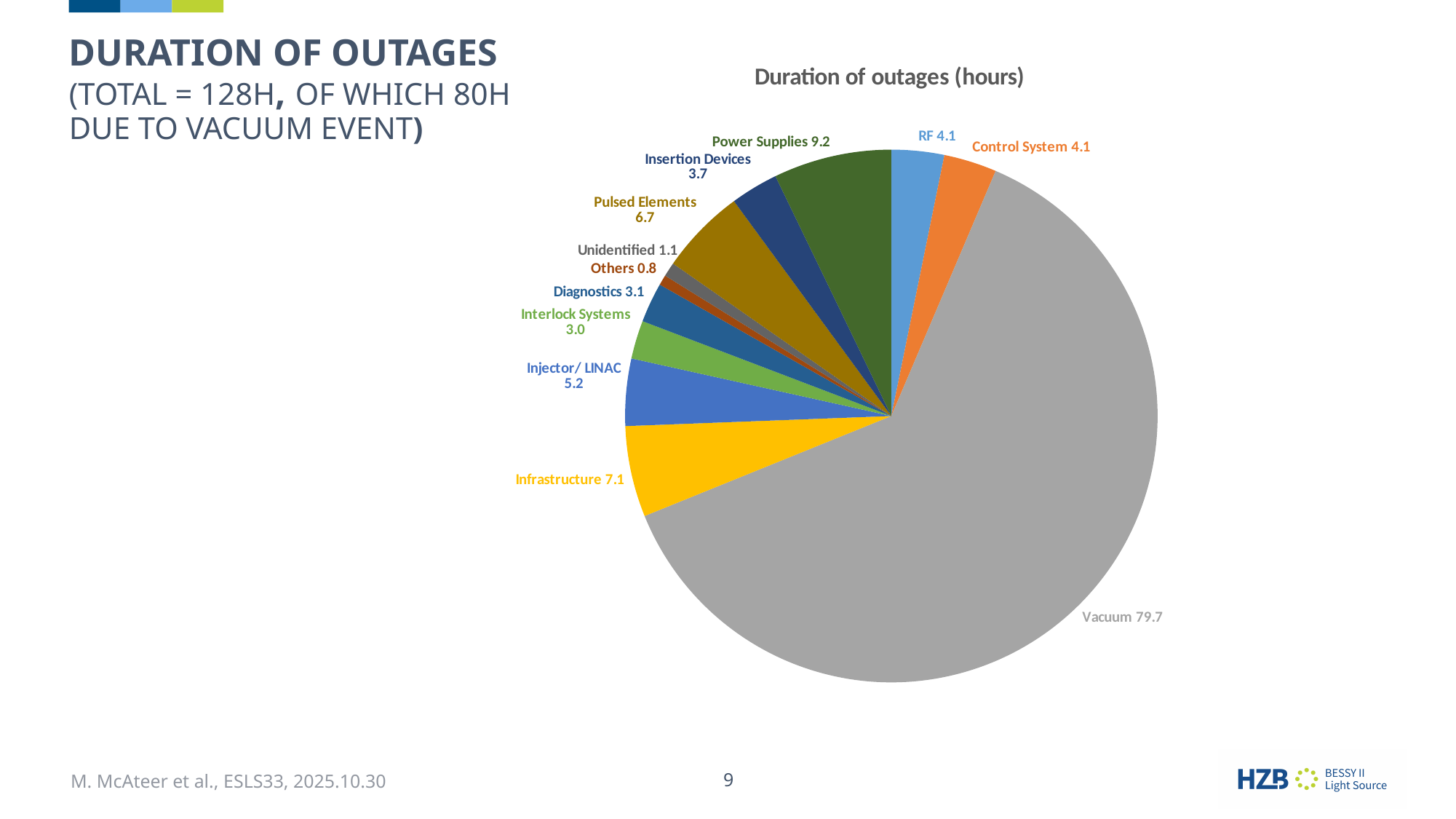
What is the duration of outages for Unidentified? 1.1 Which category has the smallest duration of outages? Others What is the title of the chart? Duration of outages (hours) Which has a longer outage duration, Pulsed Elements or Injector/ LINAC? Pulsed Elements What colour is the Vacuum slice? grey What is the duration of outages for Injector/ LINAC? 5.2 What is the duration of outages for Vacuum? 79.7 How many slices does the pie chart have? 12 What type of chart is shown on the slide? pie chart What is the duration of outages for Power Supplies? 9.2 Which category has the largest duration of outages? Vacuum What is the difference in outage duration between Vacuum and Power Supplies? 70.5